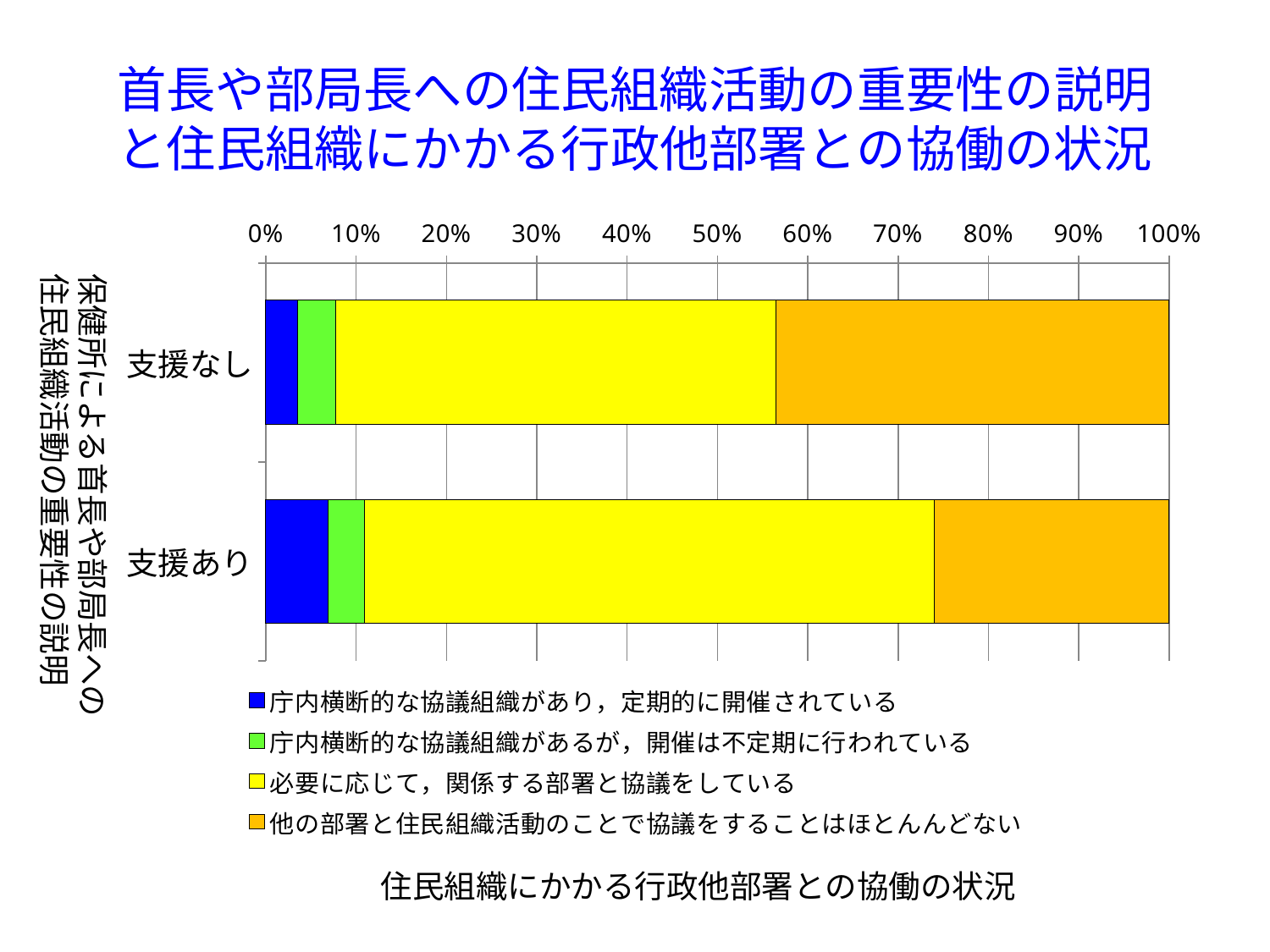
Which category has the larger share of 他の部署と住民組織活動のことで協議をすることはほとんんどない, 支援なし or 支援あり? 支援なし Is the value of 他の部署と住民組織活動のことで協議をすることはほとんんどない for 支援なし greater or less than 40%? greater What is the total of the stacked bar for 支援なし? 100% Is the value of 必要に応じて，関係する部署と協議をしている for 支援あり greater or less than 60%? greater Which category has the larger share of 必要に応じて，関係する部署と協議をしている, 支援なし or 支援あり? 支援あり How many series does the chart's legend list? 4 Is the value of 庁内横断的な協議組織があり，定期的に開催されている for 支援あり greater or less than 10%? less What are the two category labels on the vertical axis? 支援なし, 支援あり What kind of chart is shown on the slide? Stacked bar chart How many categories are plotted on the vertical axis of the chart? 2 Which legend entry is shown in orange? 他の部署と住民組織活動のことで協議をすることはほとんんどない